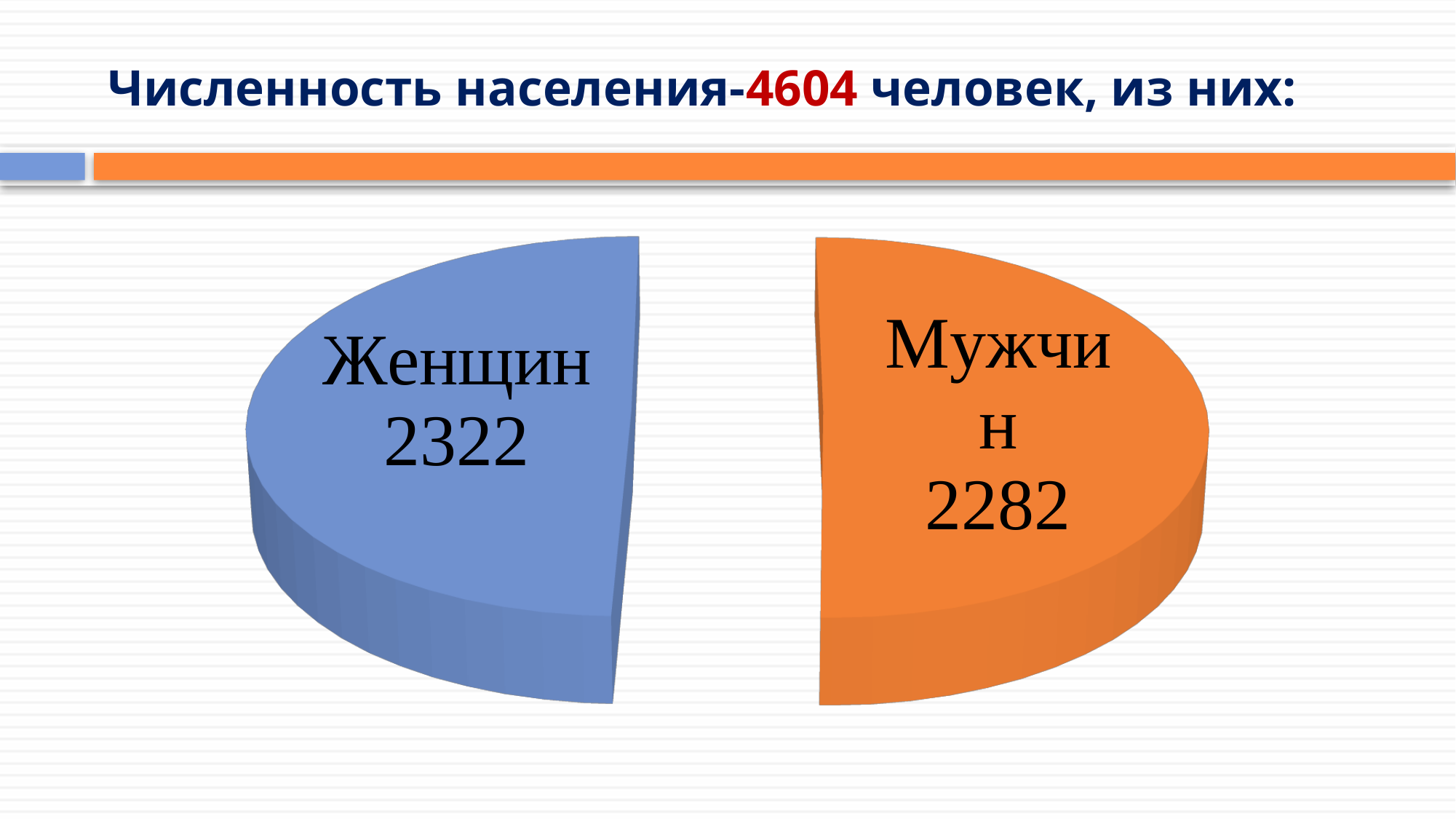
What is the value shown for Мужчин? 2282 Is the value for Женщин larger or smaller than the value for Мужчин? larger What total population figure is stated in the slide title? 4604 What colour is the slice for Мужчин? orange Which slice of the pie chart has the larger value? Женщин How many slices does the pie chart have? 2 What is the difference between the values for Женщин and Мужчин? 40 Which slice of the pie chart has the smaller value? Мужчин What is the total of the two slices in the pie chart? 4604 What kind of chart is shown on the slide? pie chart What is the value shown for Женщин? 2322